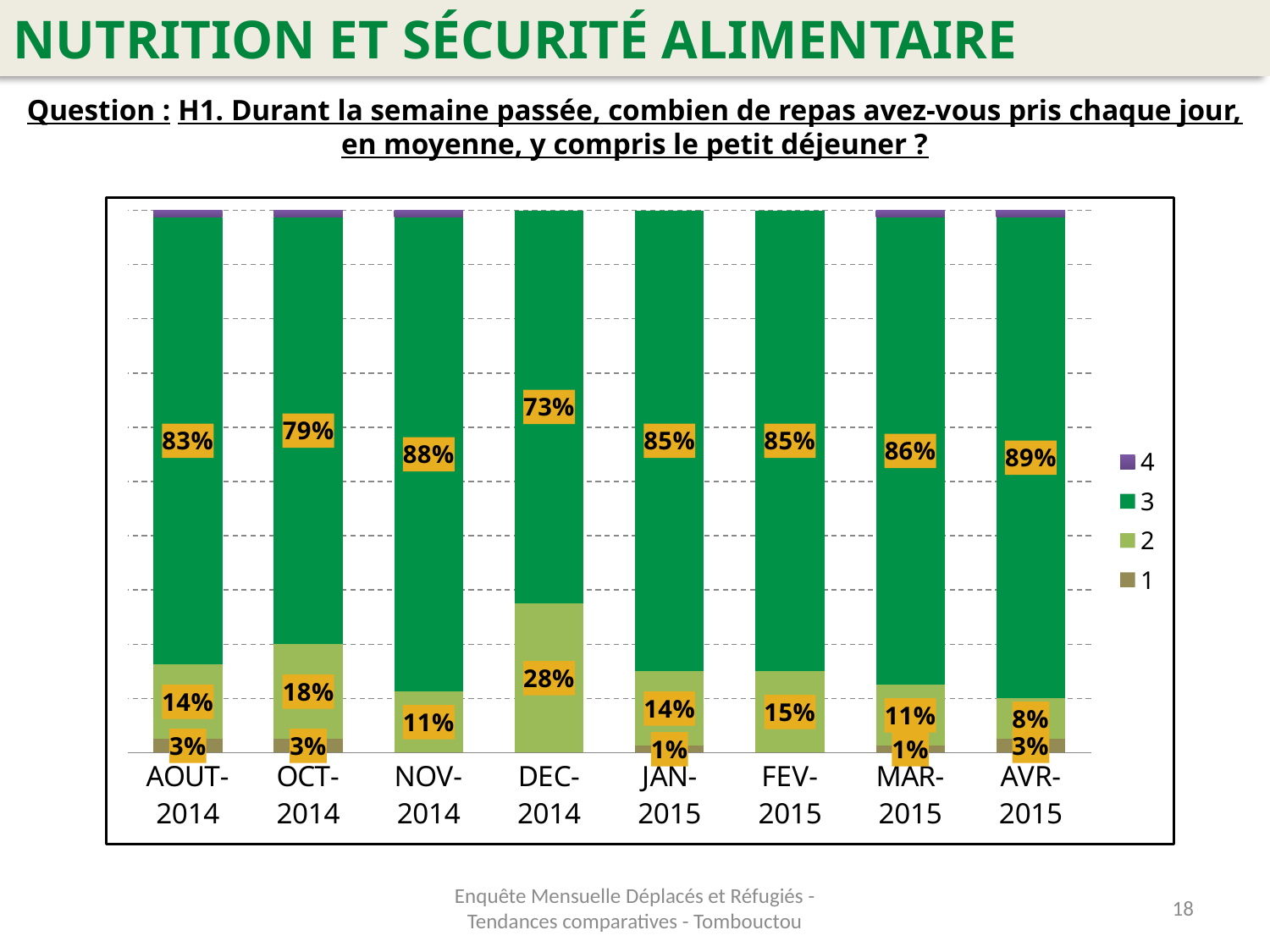
In which month is the value for series 2 the highest? DEC-2014 Which is larger, the series 2 value for FEV-2015 or for JAN-2015? FEV-2015 What is the difference between the series 3 values for AVR-2015 and DEC-2014? 16% What kind of chart is shown on the slide? Stacked bar chart In which month is the value for series 3 the lowest? DEC-2014 In which month is the value for series 3 the highest? AVR-2015 How many series does the legend list? 4 Does the value for series 2 rise or fall from DEC-2014 to AVR-2015? Fall What is the value for series 2 in OCT-2014? 18% What percentage of respondents reported 3 meals per day in DEC-2014? 73% What is the value for series 1 in AVR-2015? 3% How many months are shown on the x axis? 8